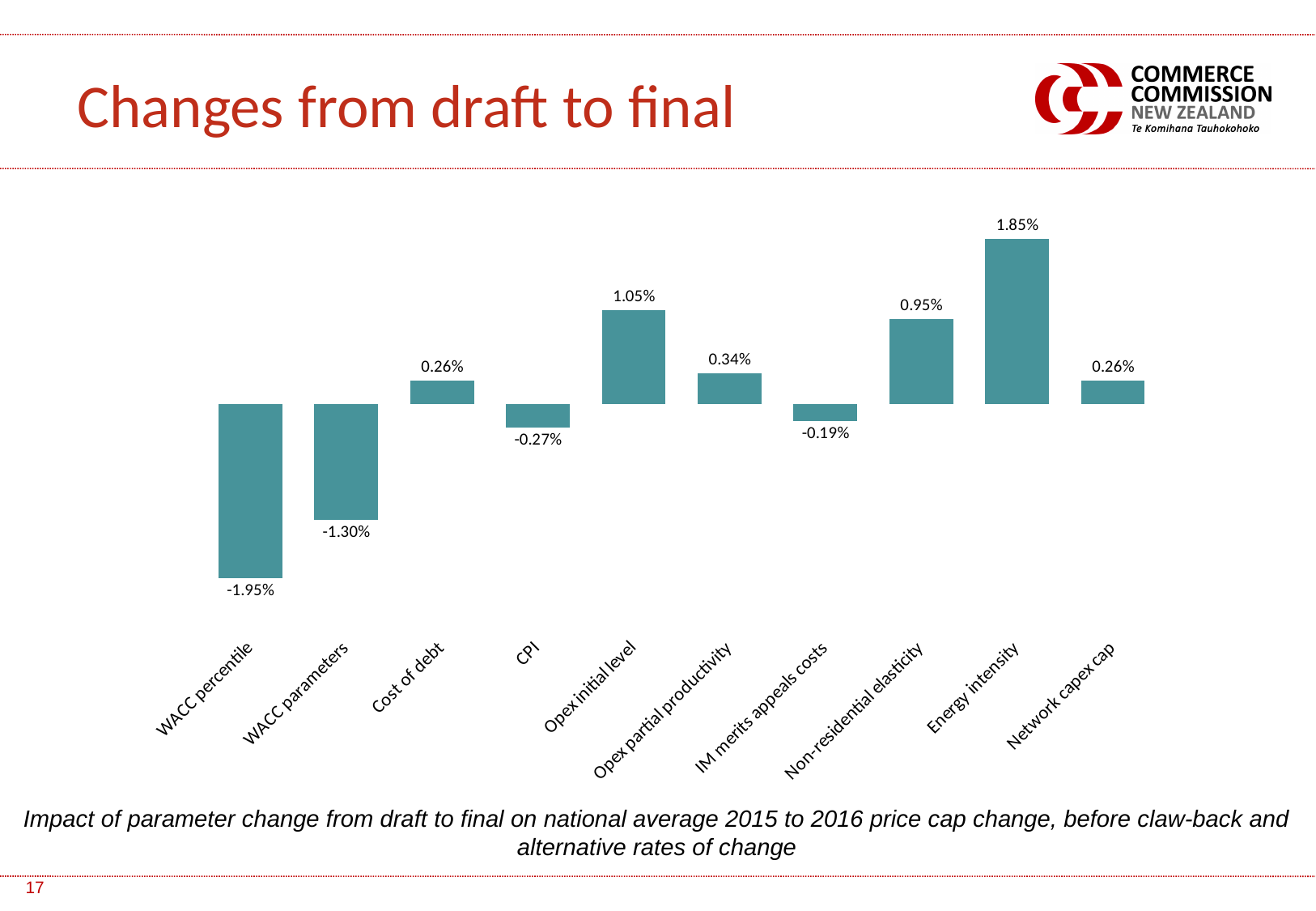
What is the value for CPI? -0.27% Which category has the highest value? Energy intensity What is the title of the slide? Changes from draft to final What kind of chart is shown on the slide? Bar chart Which is larger, the value for Opex initial level or the value for Non-residential elasticity? Opex initial level Which category has the lowest value? WACC percentile What is the difference between the values for Energy intensity and Opex initial level? 0.80% What is the difference between the values for Non-residential elasticity and Opex partial productivity? 0.61% How many categories are shown in the chart? 10 What is the value for WACC parameters? -1.30% What is the value for IM merits appeals costs? -0.19% What is the value for Energy intensity? 1.85%